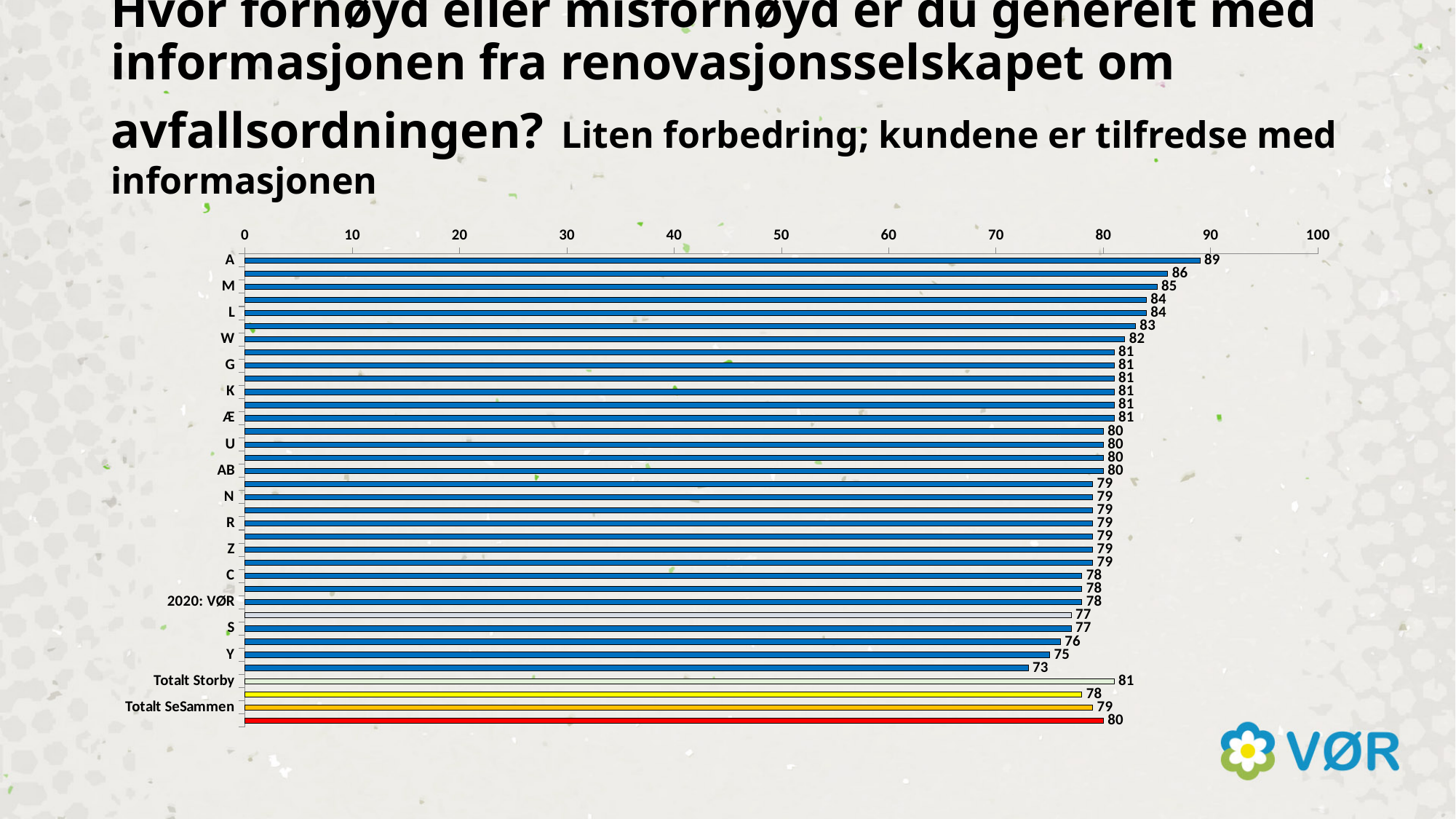
What is the value for 2020: VØR? 78 Is the value for W greater or less than 80? greater What is the value for A? 89 What is the value for Totalt SeSammen? 79 What is the value for Totalt Storby? 81 What kind of chart is shown on the slide? bar chart Is the value for S greater or less than 80? less Which is larger, the value for A or the value for M? A What colour are most of the bars in the chart? blue Which category has the highest value? A What is the difference between the values for A and Y? 14 What is the value for Y? 75